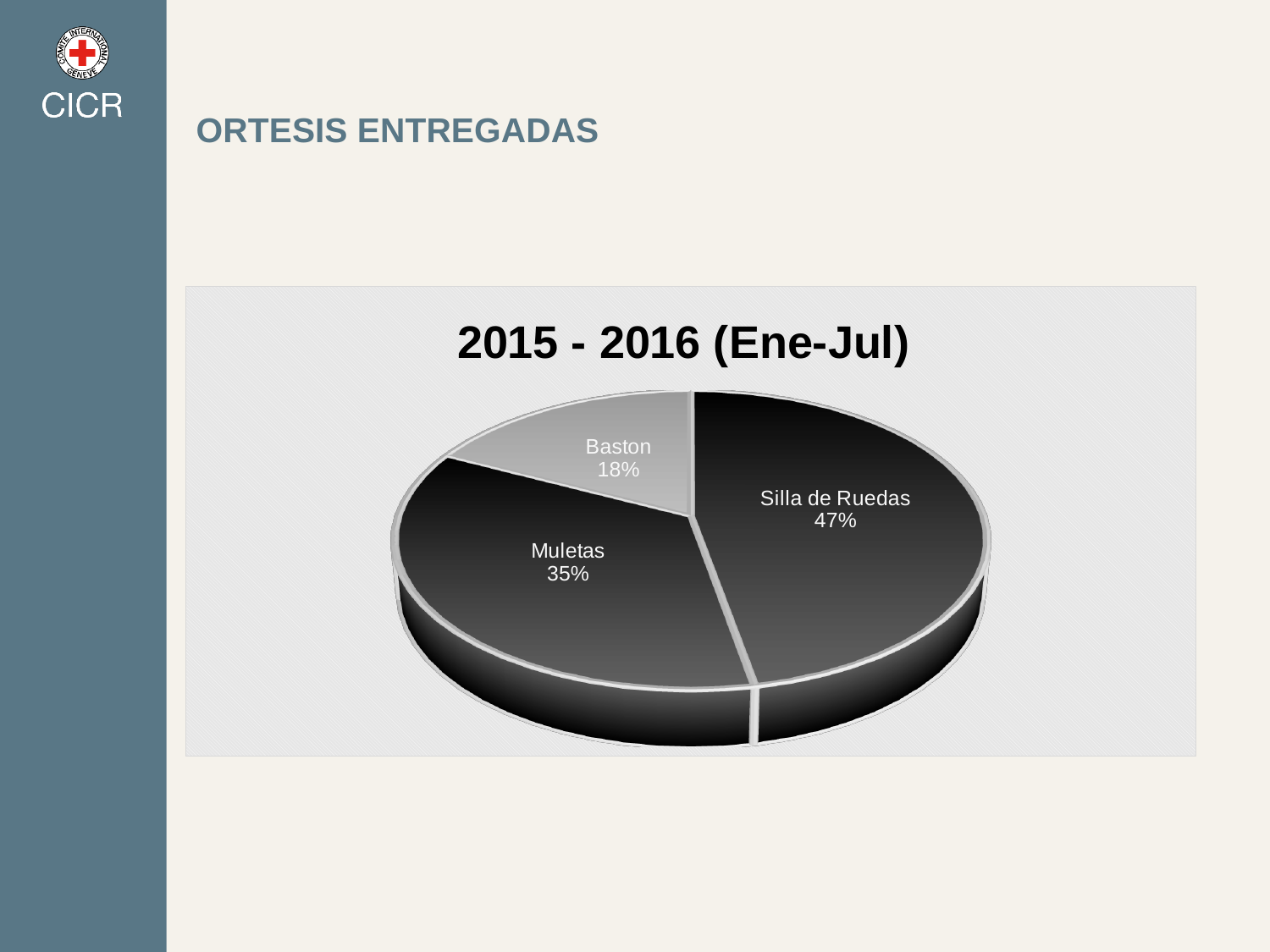
Which is larger, the share for Muletas or the share for Baston? Muletas Which category has the smallest slice of the pie? Baston What is the difference in percentage points between Silla de Ruedas and Muletas? 12 What share of the pie does Baston represent? 18% What share of the pie does Silla de Ruedas represent? 47% How many categories are shown in the pie chart? 3 What is the title of the chart? 2015 - 2016 (Ene-Jul) What kind of chart is shown on the slide? Pie chart What is the difference in percentage points between Muletas and Baston? 17 Which slice of the pie is shown in the lightest colour? Baston Which category has the largest slice of the pie? Silla de Ruedas What share of the pie does Muletas represent? 35%